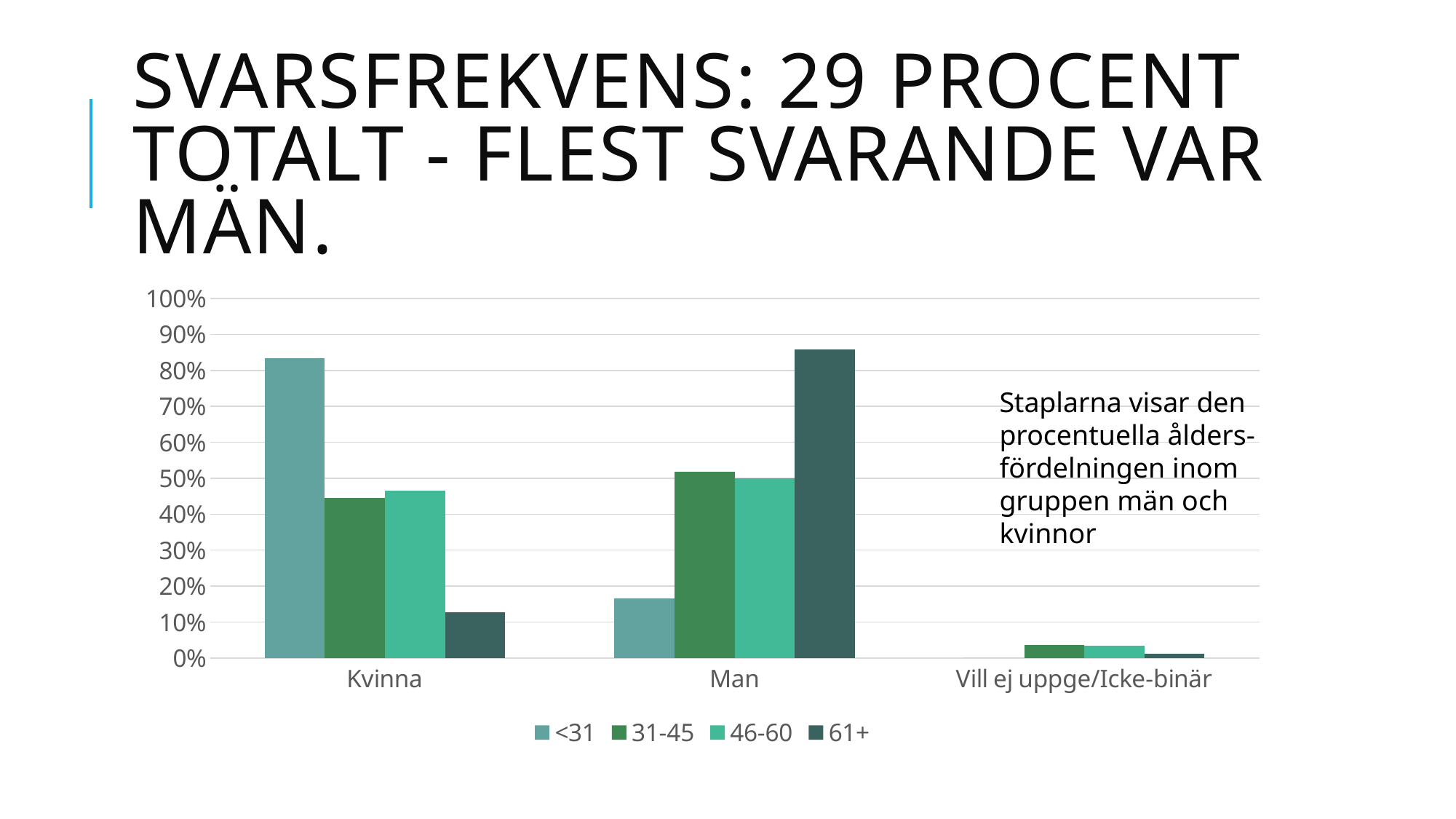
What kind of chart is shown on the slide? bar chart How many series does the chart's legend list? 4 Which age group has the highest bar in the Man category? 61+ Which is larger: the 61+ value for Kvinna or the 61+ value for Man? Man How many categories are shown on the x axis of the chart? 3 What are the four series listed in the chart's legend? <31, 31-45, 46-60, 61+ Which is larger: the <31 value for Kvinna or the <31 value for Man? Kvinna Which age group has the highest bar in the Kvinna category? <31 Is the value for <31 in the Kvinna category greater or less than 70%? greater Which age group has the lowest bar in the Man category? <31 Is the value for 61+ in the Kvinna category greater or less than 20%? less Is the value for 61+ in the Man category greater or less than 80%? greater